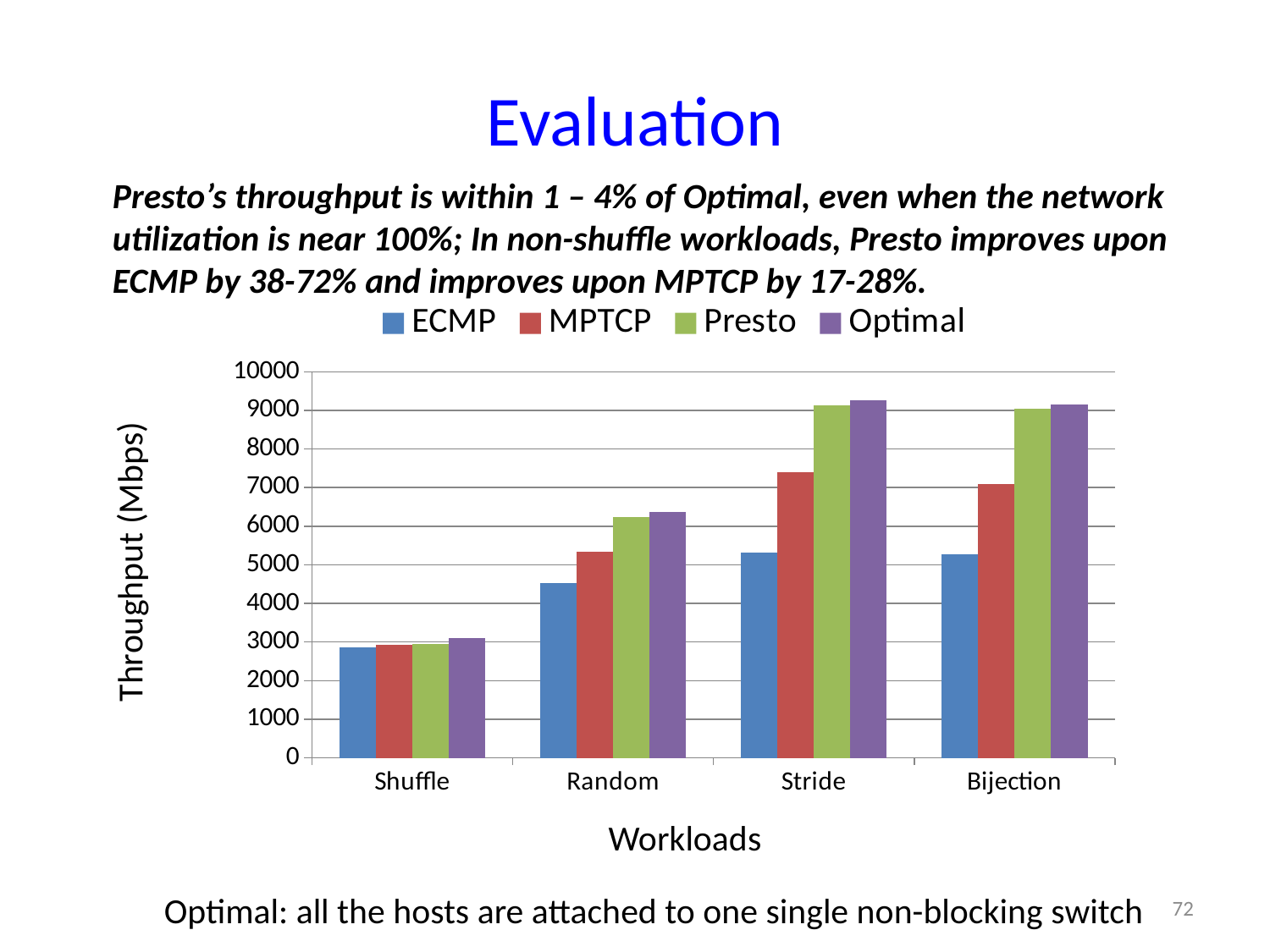
What is the label of the y axis? Throughput (Mbps) For which workload is the ECMP throughput lowest? Shuffle Is the MPTCP value for Stride greater or less than 7000? greater For the Bijection workload, which is larger: Presto or MPTCP? Presto How many workloads are shown on the x axis? 4 Is the Presto value for Bijection greater or less than 8000? greater How many series does the legend list? 4 Is the ECMP value for Random greater or less than 5000? less Which series has the lowest throughput for the Stride workload? ECMP What kind of chart is shown on the slide? bar chart Which is larger: the MPTCP value for Random or the MPTCP value for Stride? Stride